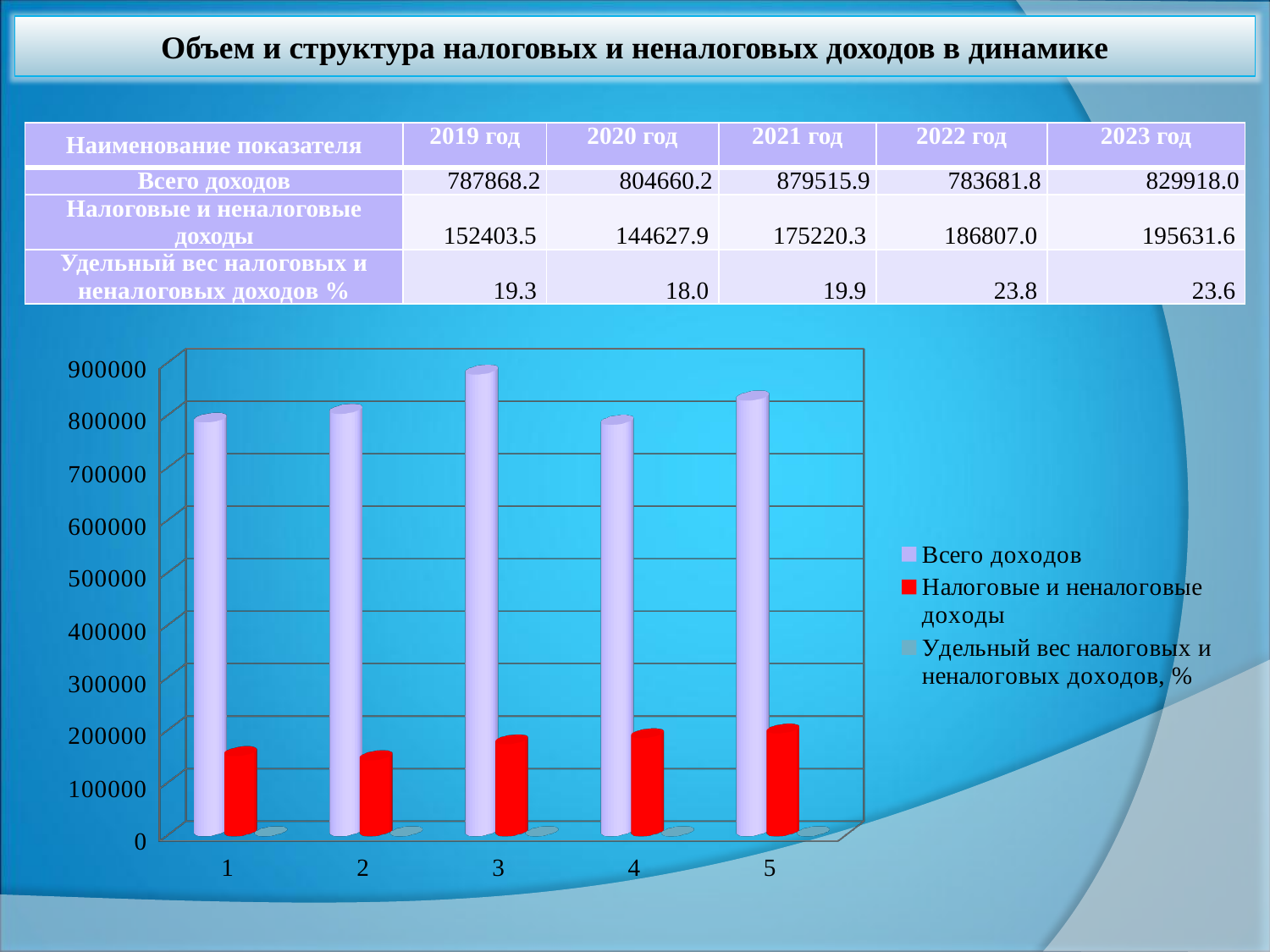
Is the value of Налоговые и неналоговые доходы for category 2 greater or less than 100000? greater Do the values of Налоговые и неналоговые доходы rise or fall from category 2 to category 5? rise How many series does the chart legend list? 3 Which is larger for Налоговые и неналоговые доходы: category 5 or category 2? category 5 Which is larger for Всего доходов: category 3 or category 2? category 3 What kind of chart is shown on the slide? bar chart How many categories are shown along the x axis of the chart? 5 Is the value of Всего доходов for category 3 greater or less than 800000? greater What colour represents the series Налоговые и неналоговые доходы in the chart? red Is the value of Всего доходов for category 2 greater or less than 700000? greater For the series Всего доходов, which category has the tallest bar? 3